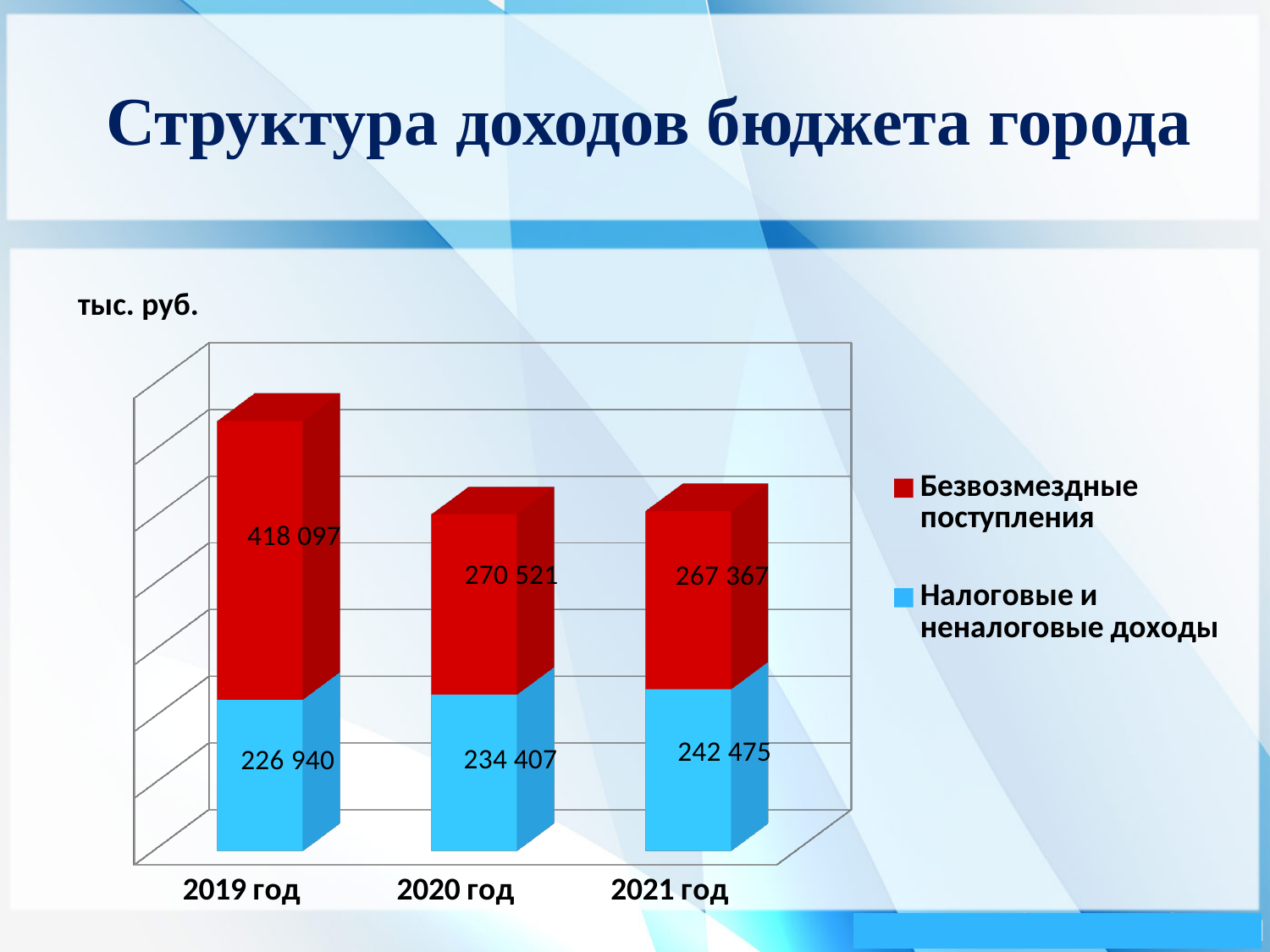
What is the value of Налоговые и неналоговые доходы for 2021 год? 242 475 Do the values of Налоговые и неналоговые доходы rise or fall from 2019 год to 2021 год? Rise Which is larger in 2020 год: Безвозмездные поступления or Налоговые и неналоговые доходы? Безвозмездные поступления What is the value of Безвозмездные поступления for 2020 год? 270 521 How many years are shown on the x axis? 3 In which year is Налоговые и неналоговые доходы the lowest? 2019 год What is the total of the stacked bar for 2021 год? 509 842 What is the value of Безвозмездные поступления for 2019 год? 418 097 What is the difference between Безвозмездные поступления in 2019 год and 2020 год? 147 576 In which year is Безвозмездные поступления the highest? 2019 год What kind of chart is shown on the slide? Stacked bar chart How many series does the legend list? 2